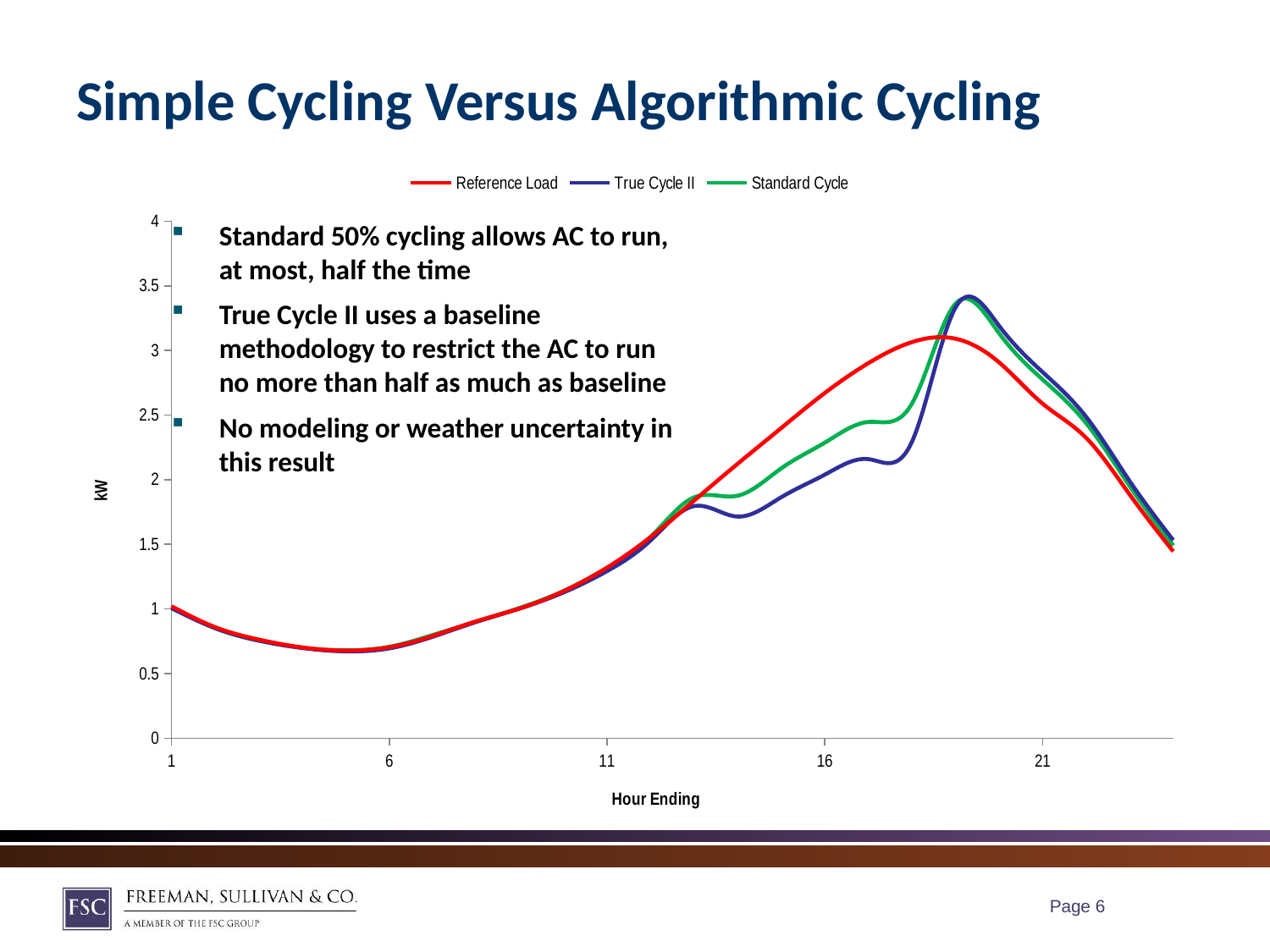
Is the Reference Load value at hour ending 1 greater or less than 1.5? less Is the peak value of the True Cycle II series greater or less than 3? greater Which series is drawn in red in the chart? Reference Load Do the values of the Reference Load series rise or fall between hour ending 6 and hour ending 11? rise Is the peak value of the Reference Load series greater or less than 3.5? less What kind of chart is shown on the slide? Line chart Which series reaches the lowest peak value in the chart? Reference Load How many series does the chart legend list? 3 What is the label on the chart's vertical axis? kW At hour ending 16, which is larger: the Reference Load or the True Cycle II value? Reference Load